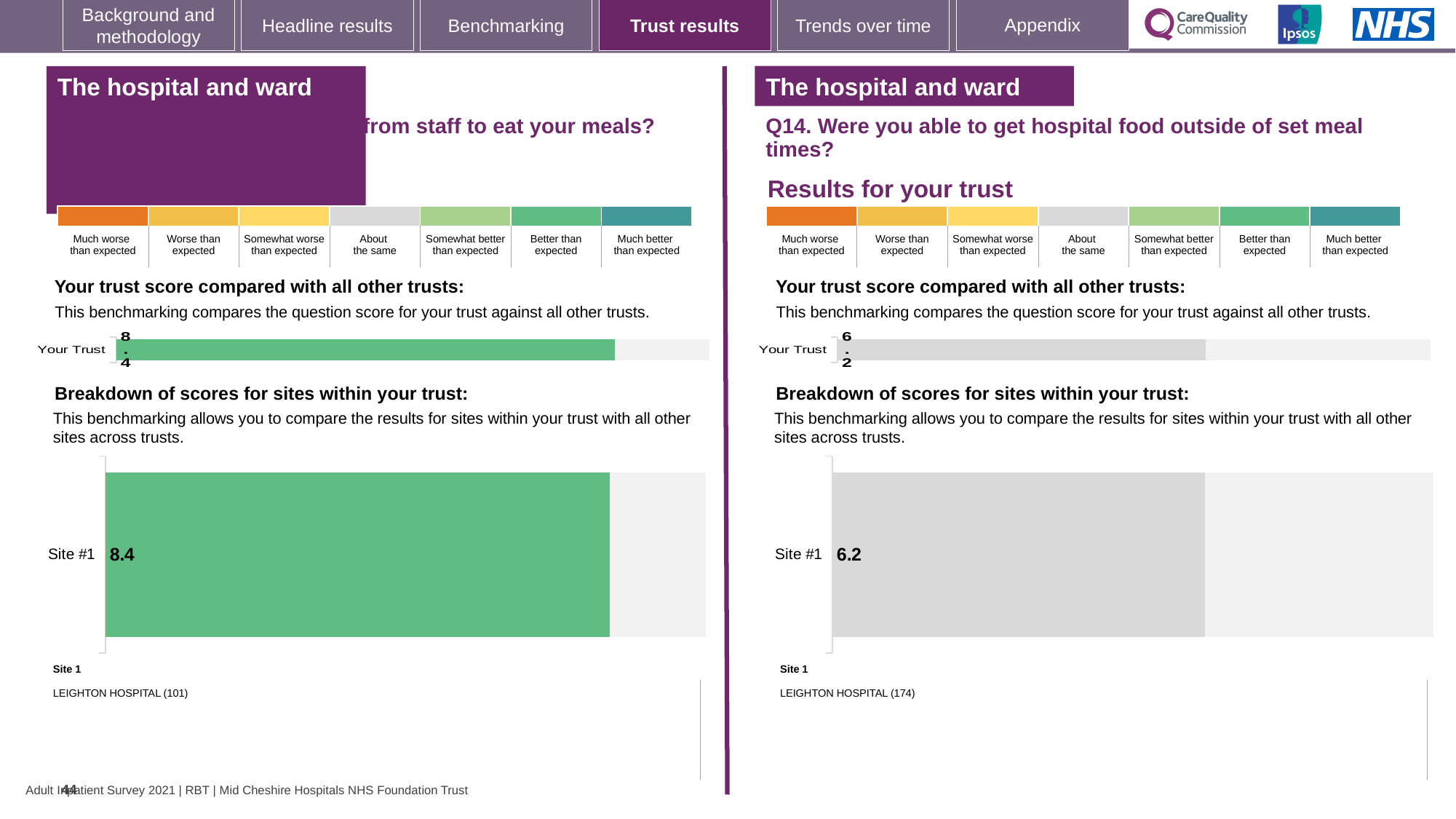
On the left-hand chart, what is the score shown for Your Trust? 8.4 How many sites are shown in the breakdown chart on the right-hand side of the slide? 1 What is the difference between the Site #1 score on the left-hand chart and the Site #1 score on the right-hand Q14 chart? 2.2 Which is larger: the Your Trust score on the left-hand chart or the Your Trust score on the right-hand Q14 chart? The left-hand chart (8.4) On the right-hand side of the slide, which hospital is listed as Site 1? LEIGHTON HOSPITAL (174) On the left-hand breakdown chart, what is the score for Site #1? 8.4 How many sites are shown in the breakdown chart on the left-hand side of the slide? 1 What kind of chart is used to show the Site #1 score on the right-hand side of the slide? Bar chart On the right-hand breakdown chart for Q14, what is the score for Site #1? 6.2 What colour is the Site #1 bar on the left-hand breakdown chart? Green On the right-hand chart for Q14, what is the score shown for Your Trust? 6.2